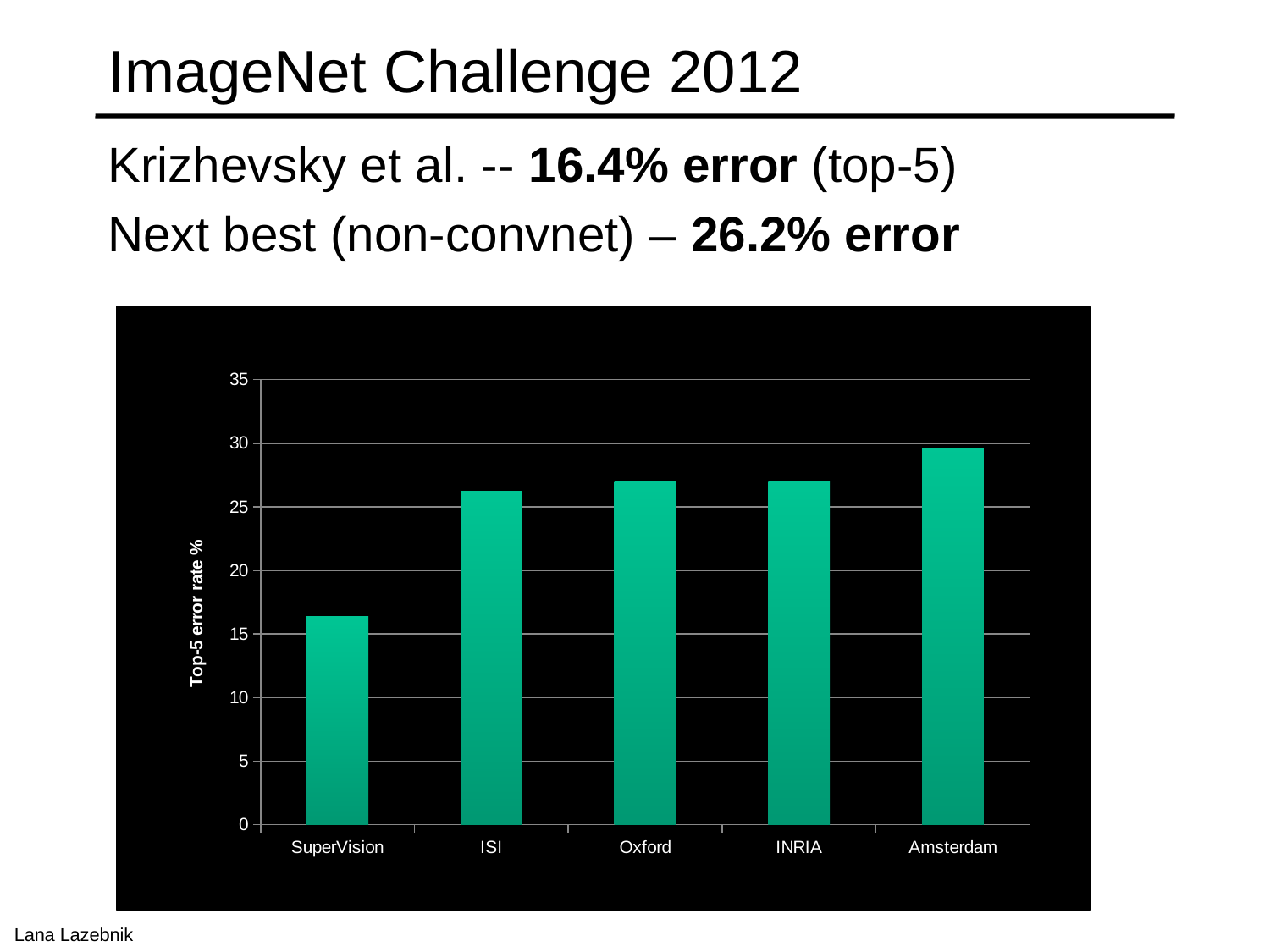
Is the top-5 error rate for Oxford greater or less than 30? less How many teams (categories) are shown on the x axis of the chart? 5 Is the top-5 error rate for SuperVision greater or less than 20? less Is the top-5 error rate for ISI greater or less than 25? greater Which has a higher top-5 error rate, INRIA or Amsterdam? Amsterdam What is the maximum value shown on the y axis of the chart? 35 Which team has the lowest top-5 error rate in the chart? SuperVision Which team has the highest top-5 error rate in the chart? Amsterdam What is the label on the y axis of the chart? Top-5 error rate % What kind of chart is shown on the slide? bar chart Which has a higher top-5 error rate, SuperVision or ISI? ISI